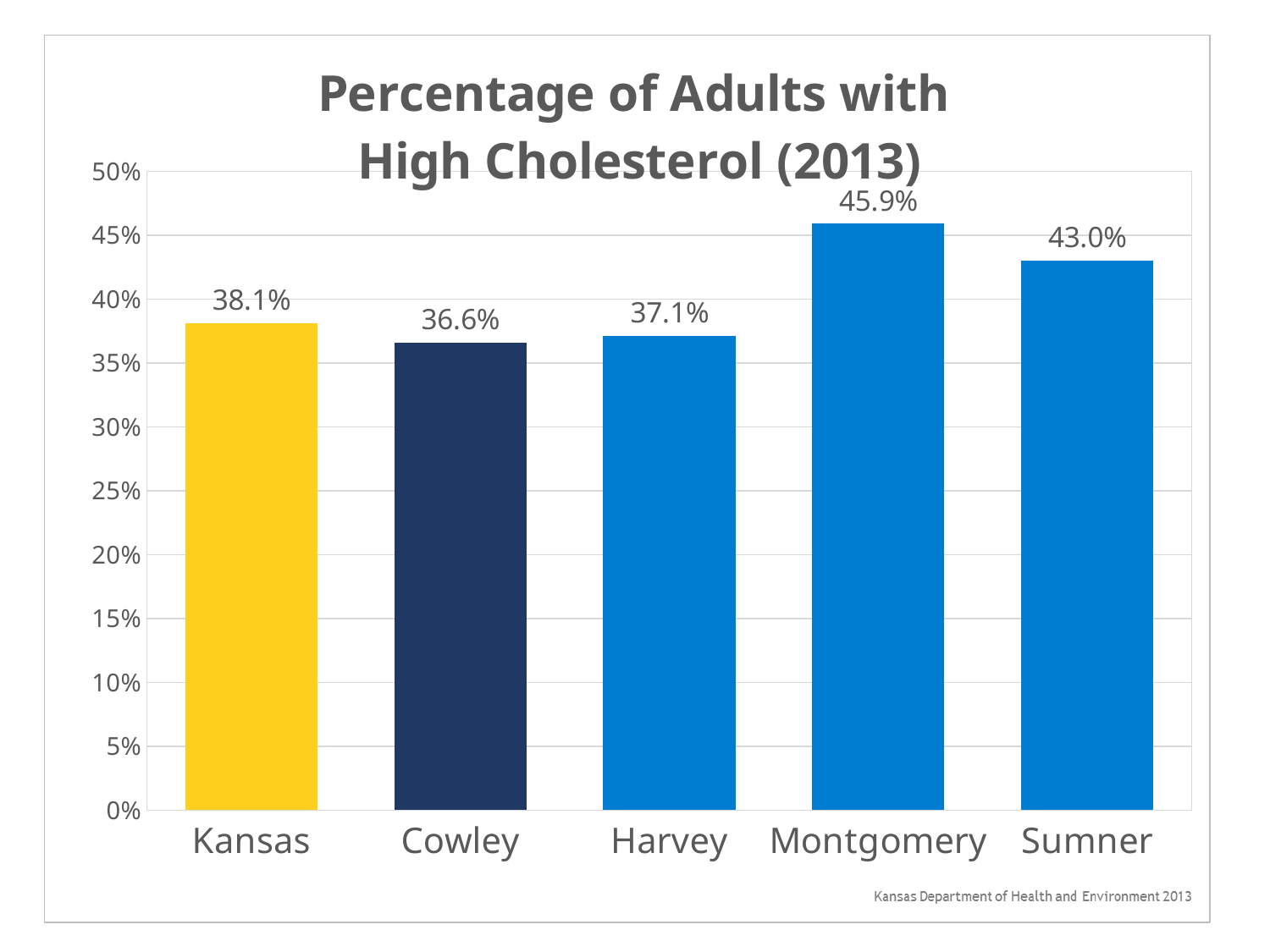
What is the difference in percentage points between Sumner and Cowley? 6.4 What is the percentage of adults with high cholesterol in Sumner? 43.0% Which category has the highest percentage of adults with high cholesterol? Montgomery Which has a higher percentage of adults with high cholesterol, Harvey or Sumner? Sumner Is the value for Montgomery greater or less than 45%? greater What is the percentage of adults with high cholesterol in Kansas? 38.1% How many categories are shown on the chart? 5 Which category has the lowest percentage of adults with high cholesterol? Cowley What kind of chart is shown on the slide? Bar chart What is the title of the chart? Percentage of Adults with High Cholesterol (2013) What is the percentage of adults with high cholesterol in Montgomery? 45.9% What is the difference in percentage points between Montgomery and Kansas? 7.8